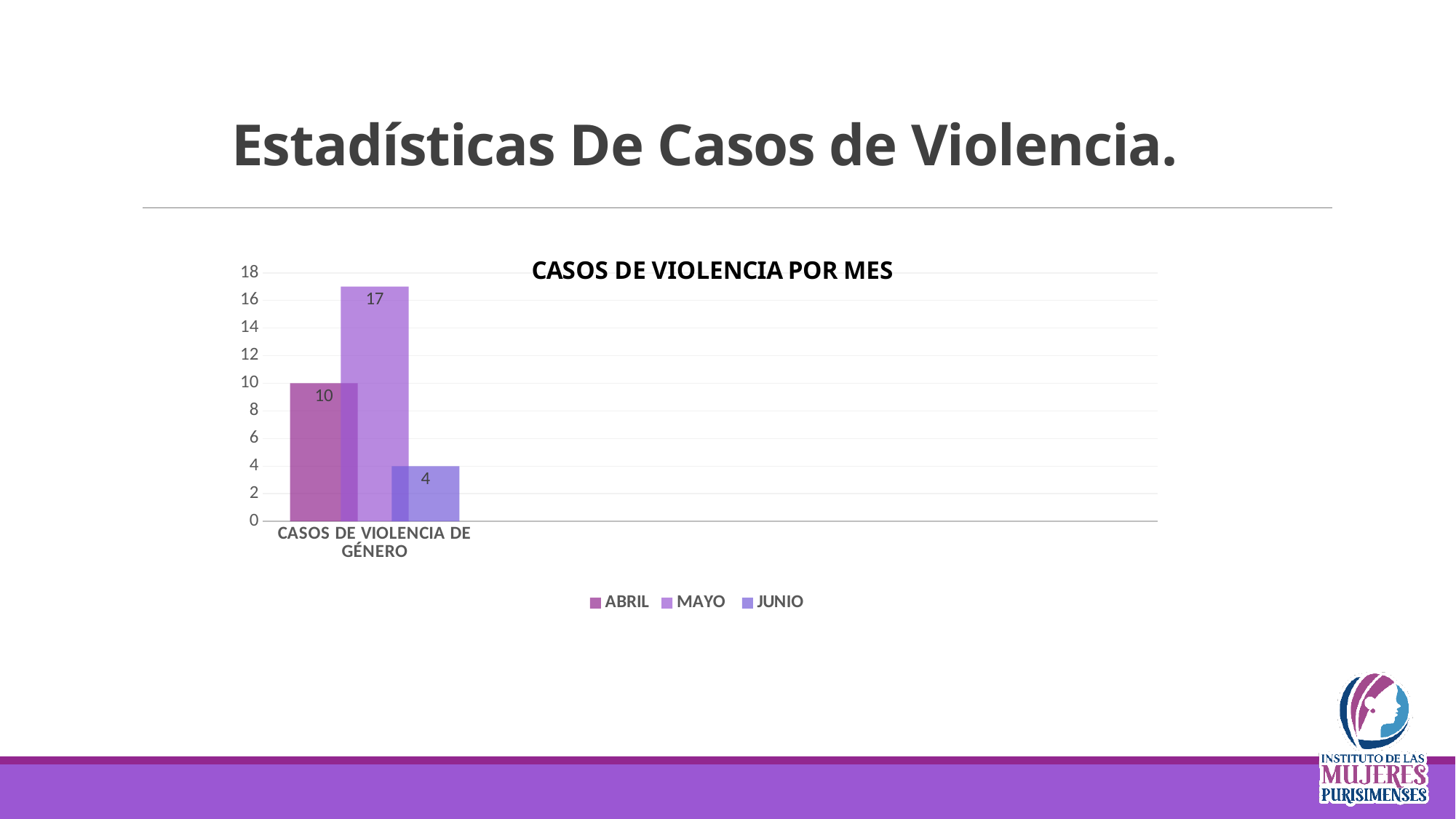
Which month has the highest number of cases? MAYO What is the value for MAYO in the chart? 17 Which is larger, the value for ABRIL or the value for JUNIO? ABRIL What is the difference between the values for MAYO and ABRIL? 7 Which month has the lowest number of cases? JUNIO How many series does the legend list? 3 What kind of chart is shown on the slide? Bar chart What is the value for ABRIL in the chart? 10 What is the category label on the x axis of the chart? CASOS DE VIOLENCIA DE GÉNERO What is the value for JUNIO in the chart? 4 What is the difference between the values for ABRIL and JUNIO? 6 What is the title of the chart? CASOS DE VIOLENCIA POR MES